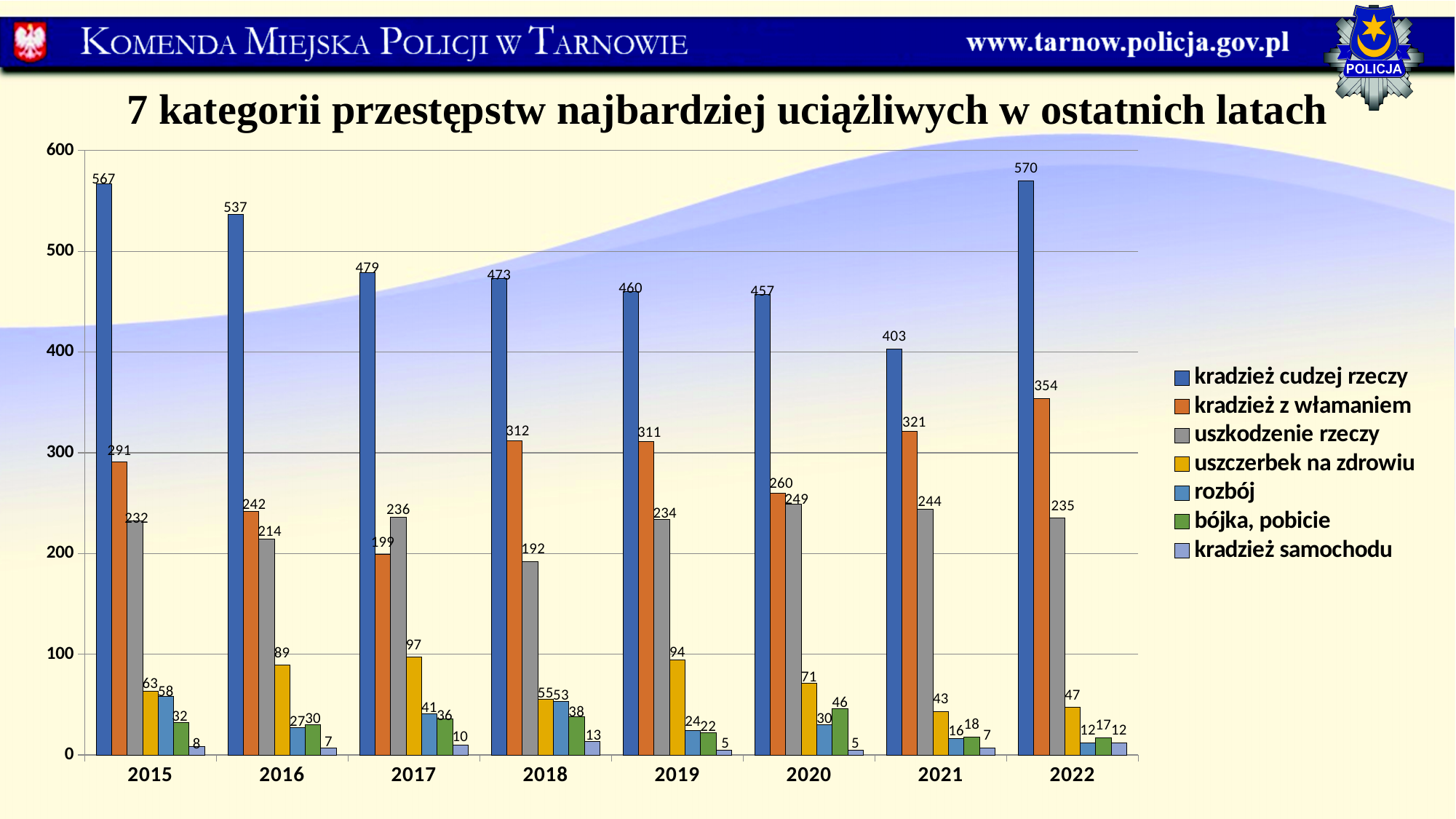
In 2017, which is larger: uszkodzenie rzeczy or kradzież z włamaniem? uszkodzenie rzeczy What is the title of the chart? 7 kategorii przestępstw najbardziej uciążliwych w ostatnich latach What is the value for uszczerbek na zdrowiu in 2019? 94 What kind of chart is shown on the slide? bar chart How many years are shown on the x axis? 8 Does kradzież cudzej rzeczy rise or fall from 2015 to 2021? fall How many series does the legend list? 7 In which year is kradzież cudzej rzeczy lowest? 2021 What is the value for kradzież cudzej rzeczy in 2022? 570 What is the value for kradzież z włamaniem in 2018? 312 In which year is kradzież cudzej rzeczy highest? 2022 What is the difference between kradzież z włamaniem in 2022 and in 2021? 33